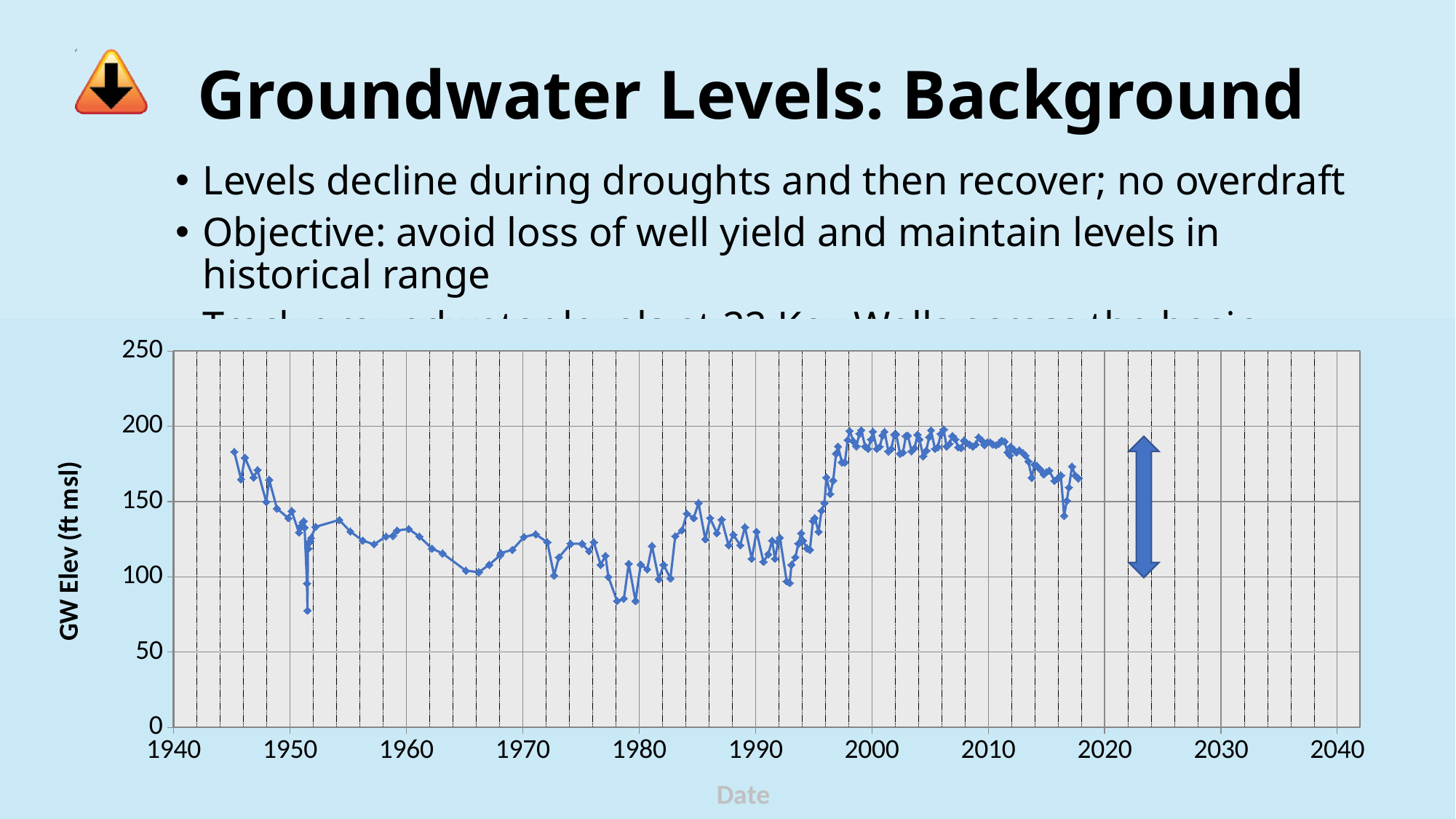
What is the label of the horizontal axis of the chart? Date Is the plotted groundwater elevation around 1990 greater or less than 150? less What is the highest value shown on the vertical axis of the chart? 250 What is the label of the vertical axis of the chart? GW Elev (ft msl) Do the plotted groundwater levels rise or fall between 1945 and 1950? fall Which is larger: the plotted groundwater elevation around 2000 or around 1980? around 2000 Is the plotted groundwater elevation around 1960 greater or less than 200? less Do the plotted groundwater levels rise or fall between 1993 and 1998? rise Is the plotted groundwater elevation around 1978 greater or less than 100? less What kind of chart is shown on the slide? line chart